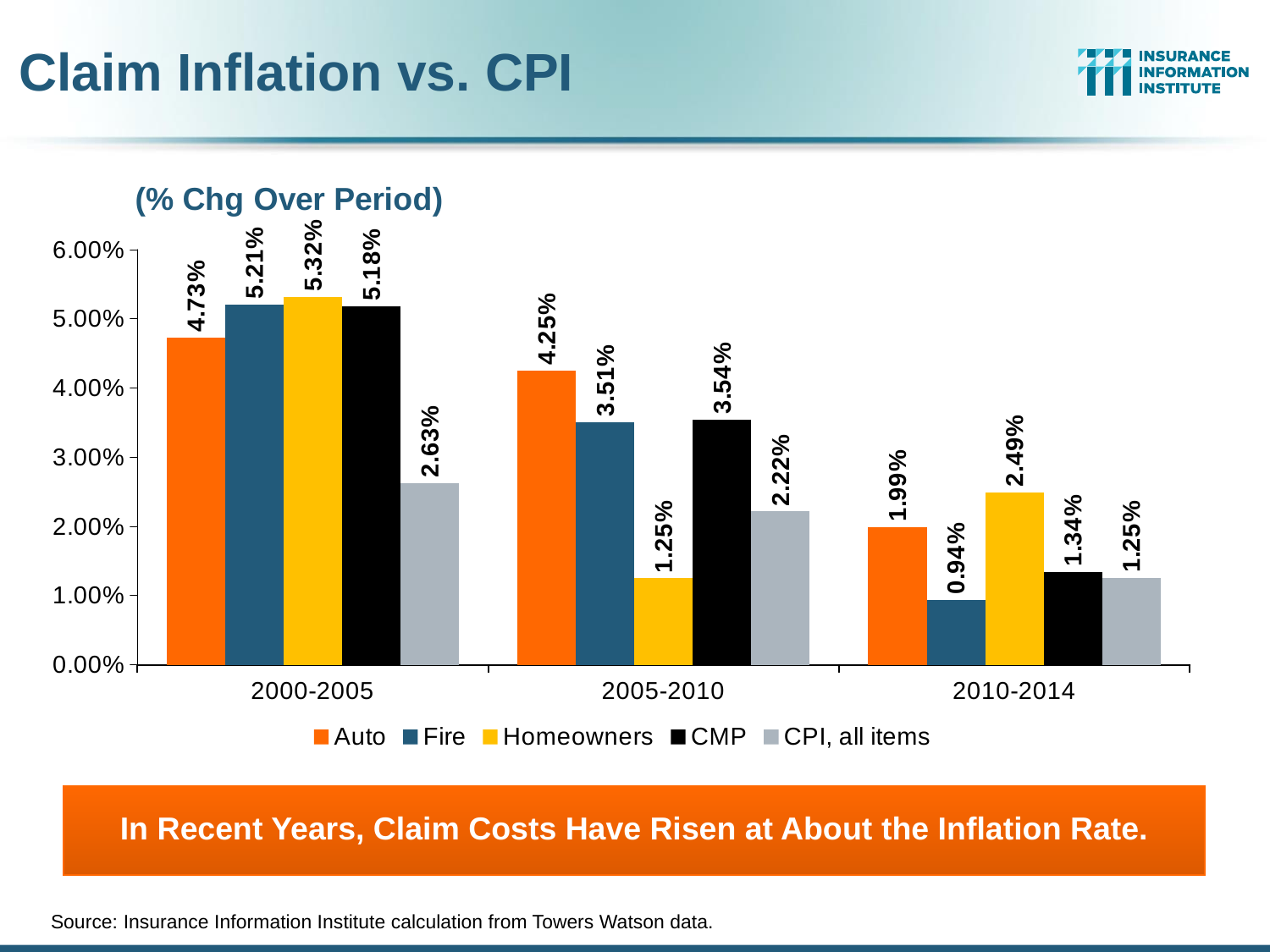
Which series has the lowest value in the 2005-2010 period? Homeowners Which is larger in the 2010-2014 period, Homeowners or CMP? Homeowners Is the value for CMP in the 2005-2010 period greater or less than 3.00%? greater How many periods are shown on the x axis? 3 What is the value for Fire in the 2010-2014 period? 0.94% Which series has the highest value in the 2000-2005 period? Homeowners What kind of chart is shown on the slide? Bar chart What is the difference between the Auto value and the CPI, all items value in the 2000-2005 period? 2.10% How many series does the legend list? 5 What is the value for Auto in the 2000-2005 period? 4.73% What is the value for CPI, all items in the 2005-2010 period? 2.22% Does the Auto value rise or fall across the periods from 2000-2005 to 2010-2014? Fall